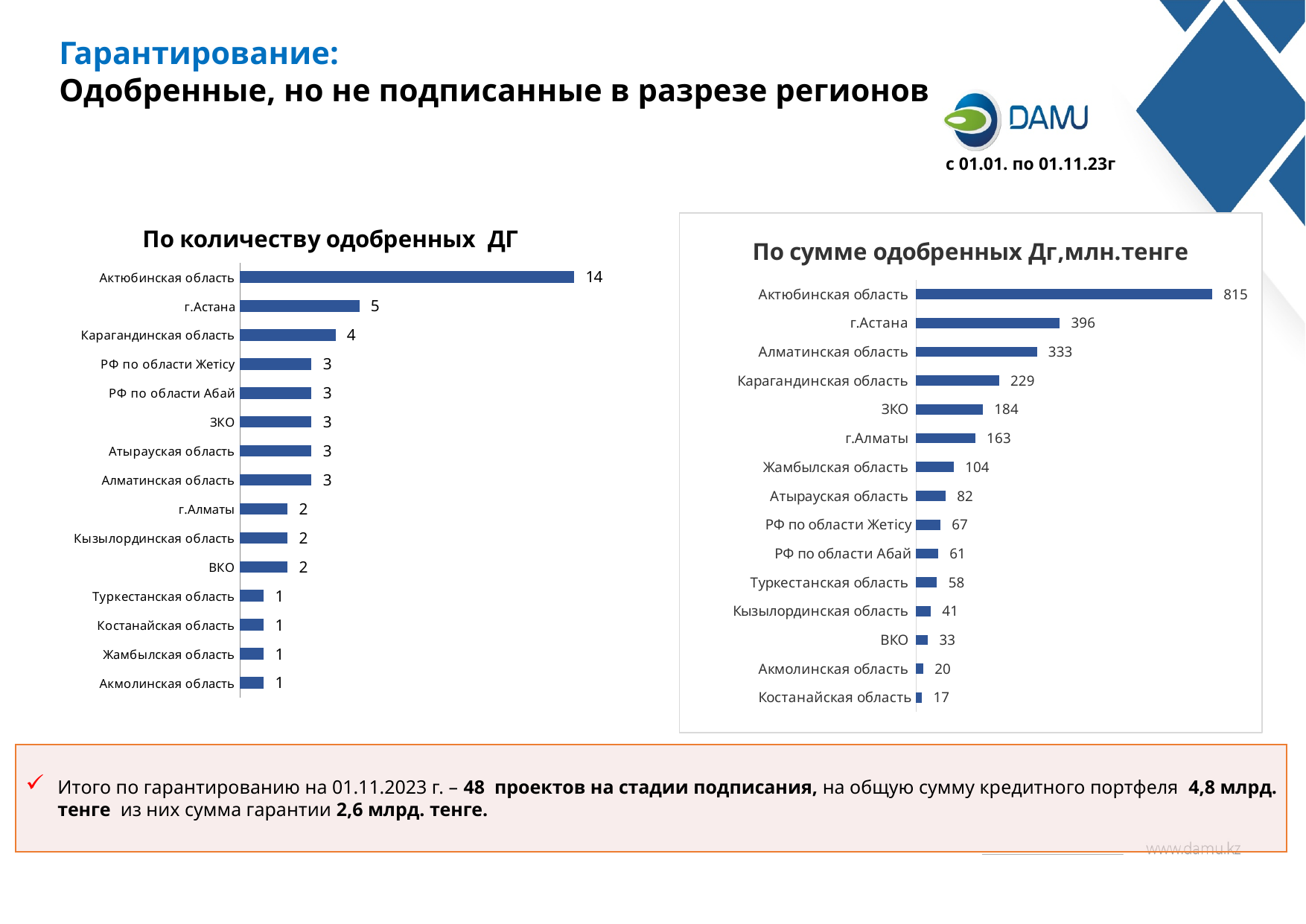
In the chart 'По сумме одобренных Дг,млн.тенге', which region has the lowest value? Костанайская область In the chart 'По сумме одобренных Дг,млн.тенге', what is the difference between Актюбинская область and г.Астана? 419 In the chart 'По количеству одобренных ДГ', which region has the highest value? Актюбинская область In the chart 'По сумме одобренных Дг,млн.тенге', what is the value for Алматинская область? 333 In the chart 'По сумме одобренных Дг,млн.тенге', what is the value for ЗКО? 184 In the chart 'По количеству одобренных ДГ', how many regions are listed? 15 In the chart 'По количеству одобренных ДГ', what is the value for г.Астана? 5 What type of chart is 'По сумме одобренных Дг,млн.тенге'? Bar chart In the chart 'По количеству одобренных ДГ', what is the difference between Актюбинская область and Карагандинская область? 10 In the chart 'По количеству одобренных ДГ', what is the value for Актюбинская область? 14 In the chart 'По сумме одобренных Дг,млн.тенге', which is larger: г.Астана or Карагандинская область? г.Астана In the chart 'По сумме одобренных Дг,млн.тенге', which region has the highest value? Актюбинская область